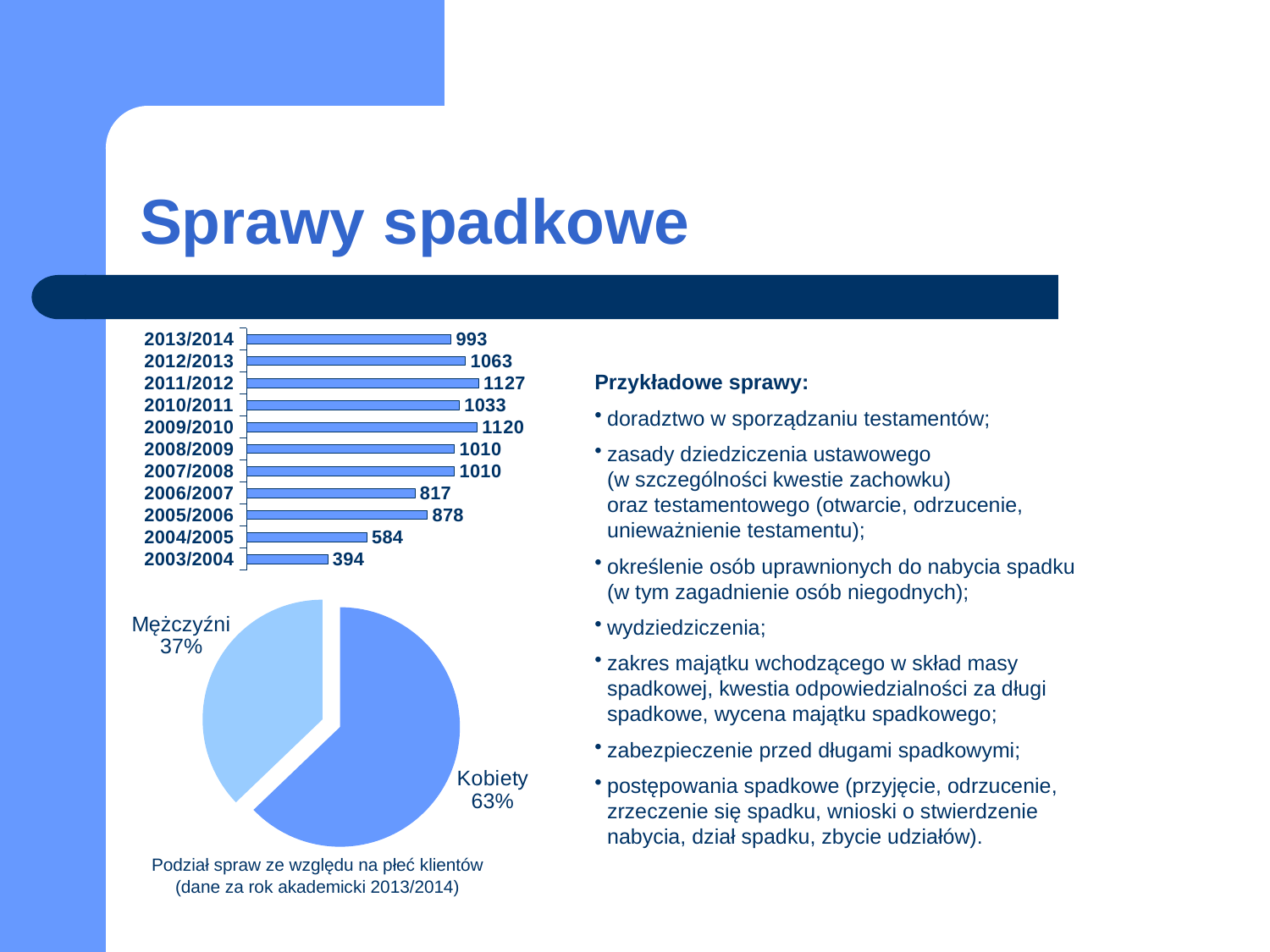
In the pie chart at the bottom left, how many slices are there? 2 In the bar chart at the top left, which academic year has the lowest value? 2003/2004 In the pie chart at the bottom left, what share is labelled Mężczyźni? 37% In the pie chart at the bottom left, what share is labelled Kobiety? 63% In the bar chart at the top left, what is the difference between the values for 2012/2013 and 2013/2014? 70 In the bar chart at the top left, which is larger, the value for 2005/2006 or the value for 2006/2007? 2005/2006 In the bar chart at the top left, what is the value for 2009/2010? 1120 In the bar chart at the top left, what is the value for 2013/2014? 993 In the bar chart at the top left, which academic year has the highest value? 2011/2012 In the bar chart at the top left, what is the value for 2003/2004? 394 What kind of chart is the chart at the top left of the slide? Bar chart In the bar chart at the top left, how many academic years are shown? 11